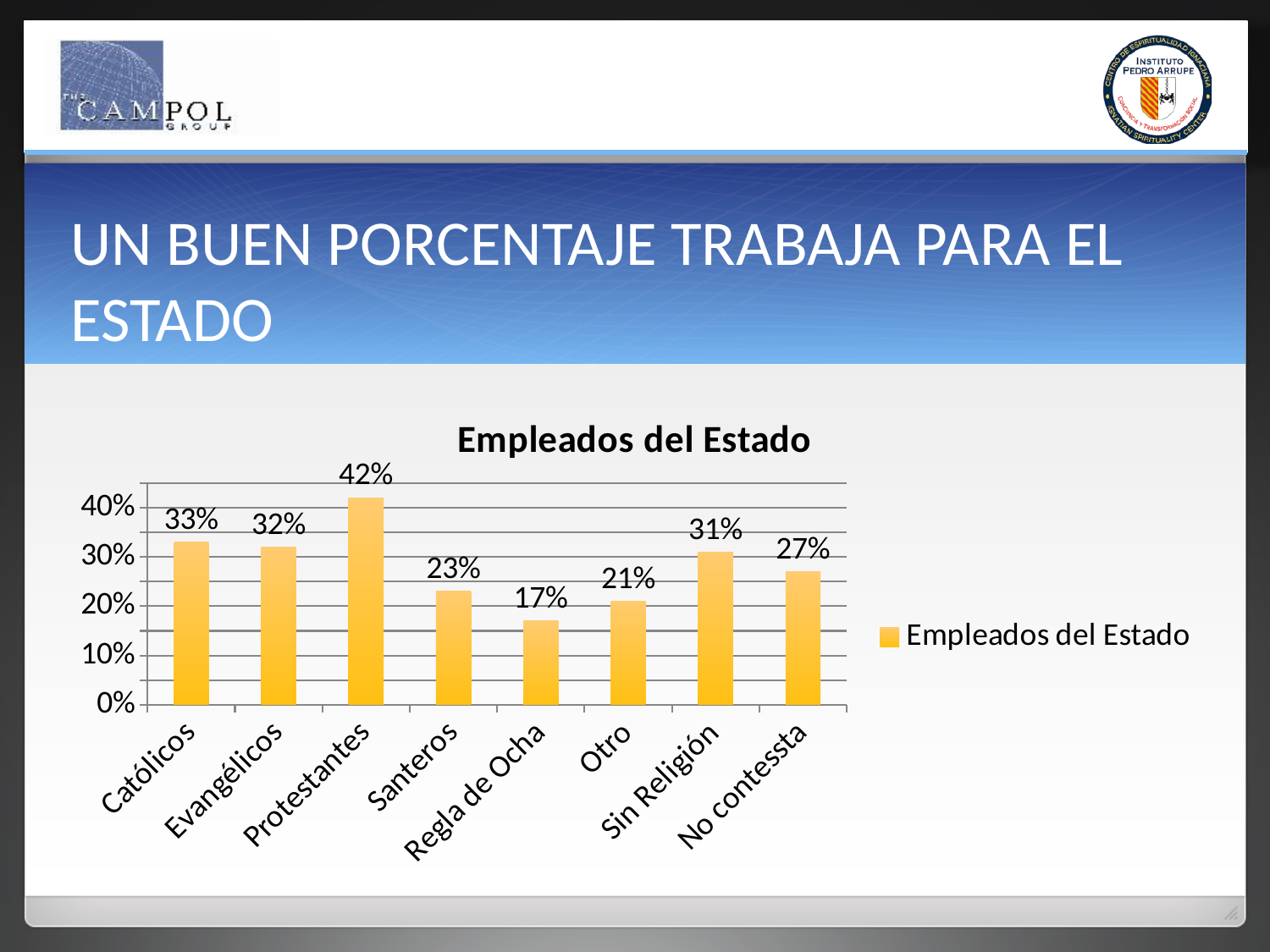
What is the difference between the values for Protestantes and Regla de Ocha? 25% What is the value for Regla de Ocha? 17% Is the value for Santeros greater or less than 30%? less Which is larger, the value for Sin Religión or the value for Otro? Sin Religión How many categories are shown on the x axis? 8 What is the value for Protestantes in the Empleados del Estado chart? 42% What kind of chart is shown on the slide? bar chart Which category has the highest value? Protestantes What is the title of the chart? Empleados del Estado What is the difference between the values for Católicos and Santeros? 10% Which category has the lowest value? Regla de Ocha What is the value for No contessta? 27%